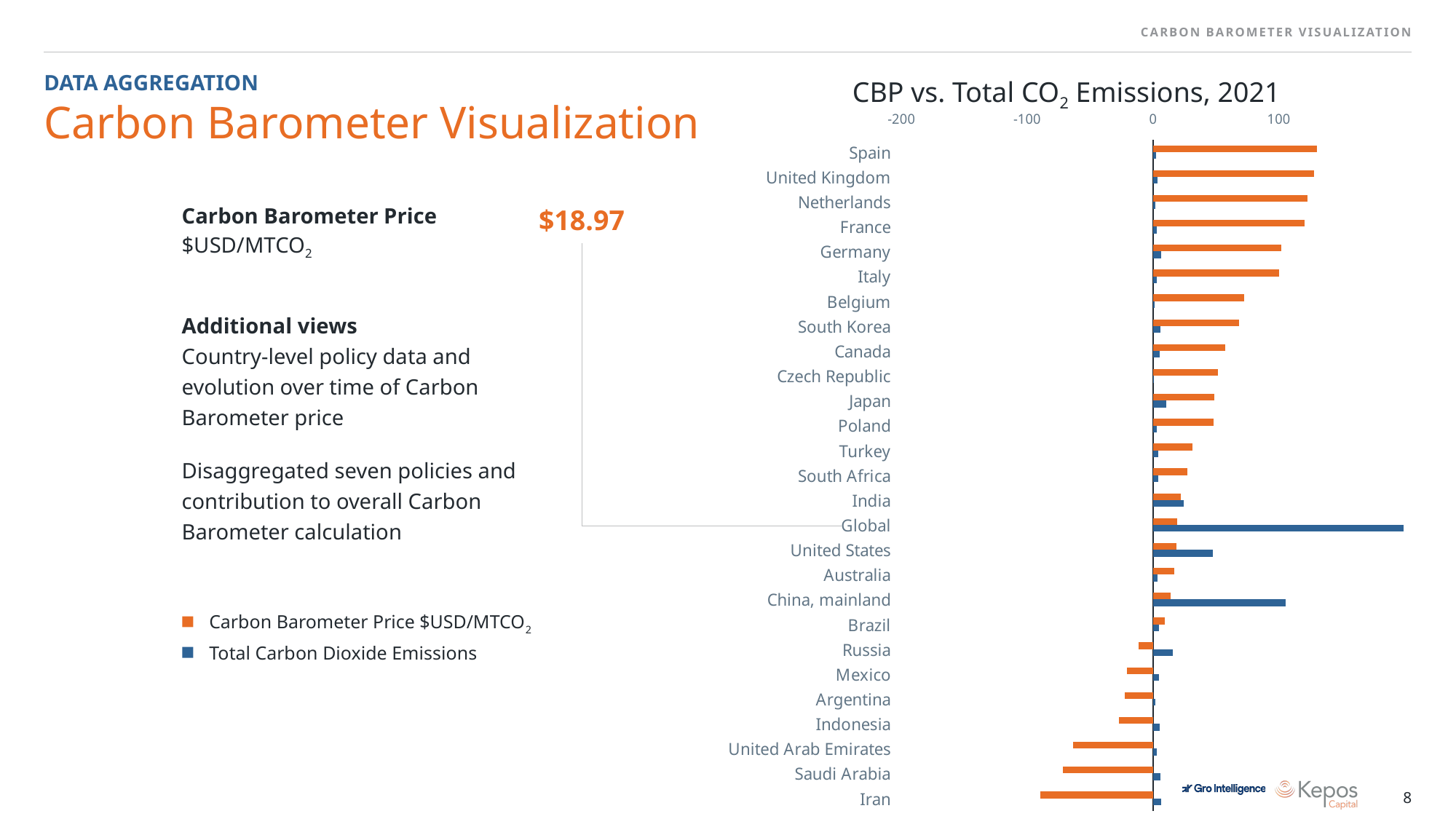
What colour represents Total Carbon Dioxide Emissions in the chart? blue How many series does the legend of the chart list? 2 Do the Carbon Barometer Price bars increase or decrease going from Spain at the top to Iran at the bottom? decrease Is the Carbon Barometer Price for Spain greater or less than 100? greater How many categories are plotted on the chart? 27 Which category has the highest Total Carbon Dioxide Emissions? Global Which has the larger Total Carbon Dioxide Emissions, Global or China, mainland? Global Is the Carbon Barometer Price for Saudi Arabia greater or less than -50? less Which category has the lowest Carbon Barometer Price? Iran What is the Carbon Barometer Price shown for Global? $18.97 What kind of chart is shown on the slide? bar chart Is the Total Carbon Dioxide Emissions value for the United States greater or less than 100? less